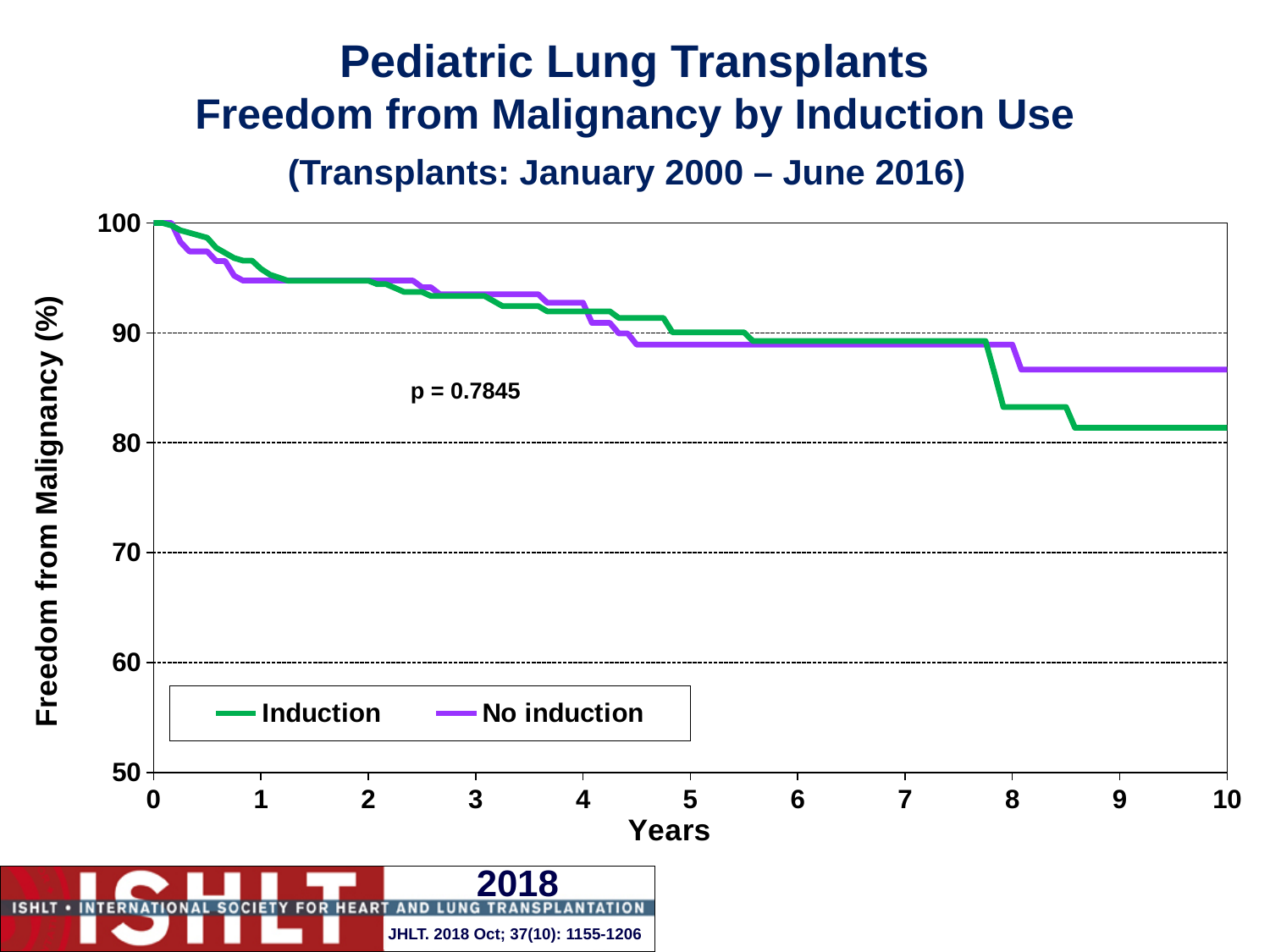
Is the value for Induction at 3 years greater or less than 90? greater Do the values for the Induction series rise or fall as years increase? fall Is the value for Induction at 10 years greater or less than 90? less At 10 years, which series has the higher freedom from malignancy, Induction or No induction? No induction Is the value for No induction at 10 years greater or less than 80? greater At 9 years, which series has the lower freedom from malignancy, Induction or No induction? Induction Do the values for the No induction series rise or fall as years increase? fall What are the two series named in the legend? Induction and No induction What p-value is printed on the chart? p = 0.7845 What kind of chart is shown on the slide? line chart How many series does the legend list? 2